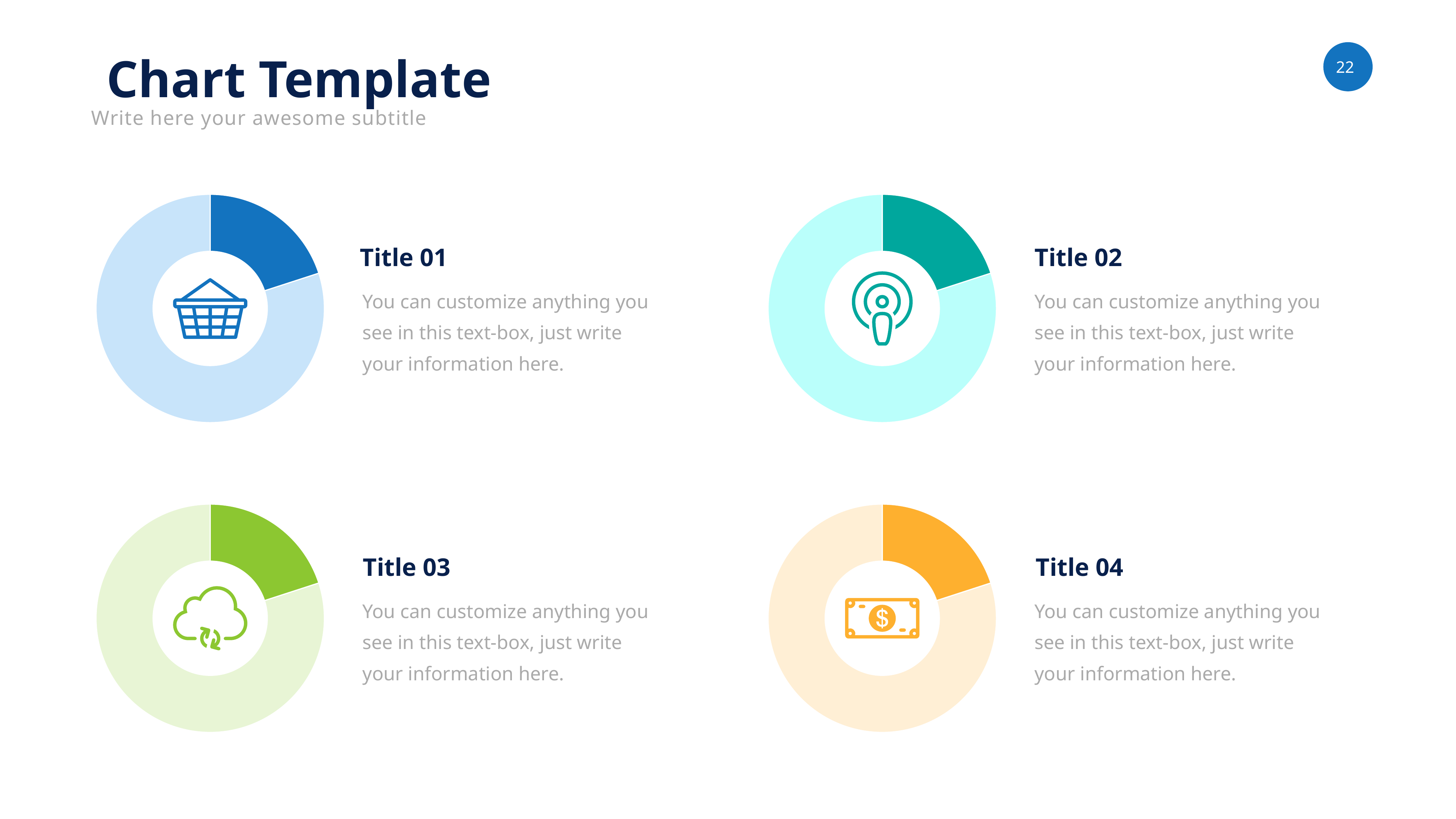
How many slices does the donut chart next to Title 01 have? 2 What kind of chart is shown next to Title 04? donut chart In the donut chart next to Title 04, which slice is the smallest? the dark orange slice How many donut charts are on the slide? 4 How many slices does the donut chart next to Title 03 have? 2 In the donut chart next to Title 03, is the dark green slice larger or smaller than the light green slice? smaller In the donut chart next to Title 02, which slice is the largest? the light teal slice What colour is the highlighted (darker) slice in the donut chart next to Title 03? green What kind of chart is shown next to Title 01? donut chart In the donut chart next to Title 01, is the dark blue slice larger or smaller than the light blue slice? smaller What colour is the highlighted (darker) slice in the donut chart next to Title 04? orange